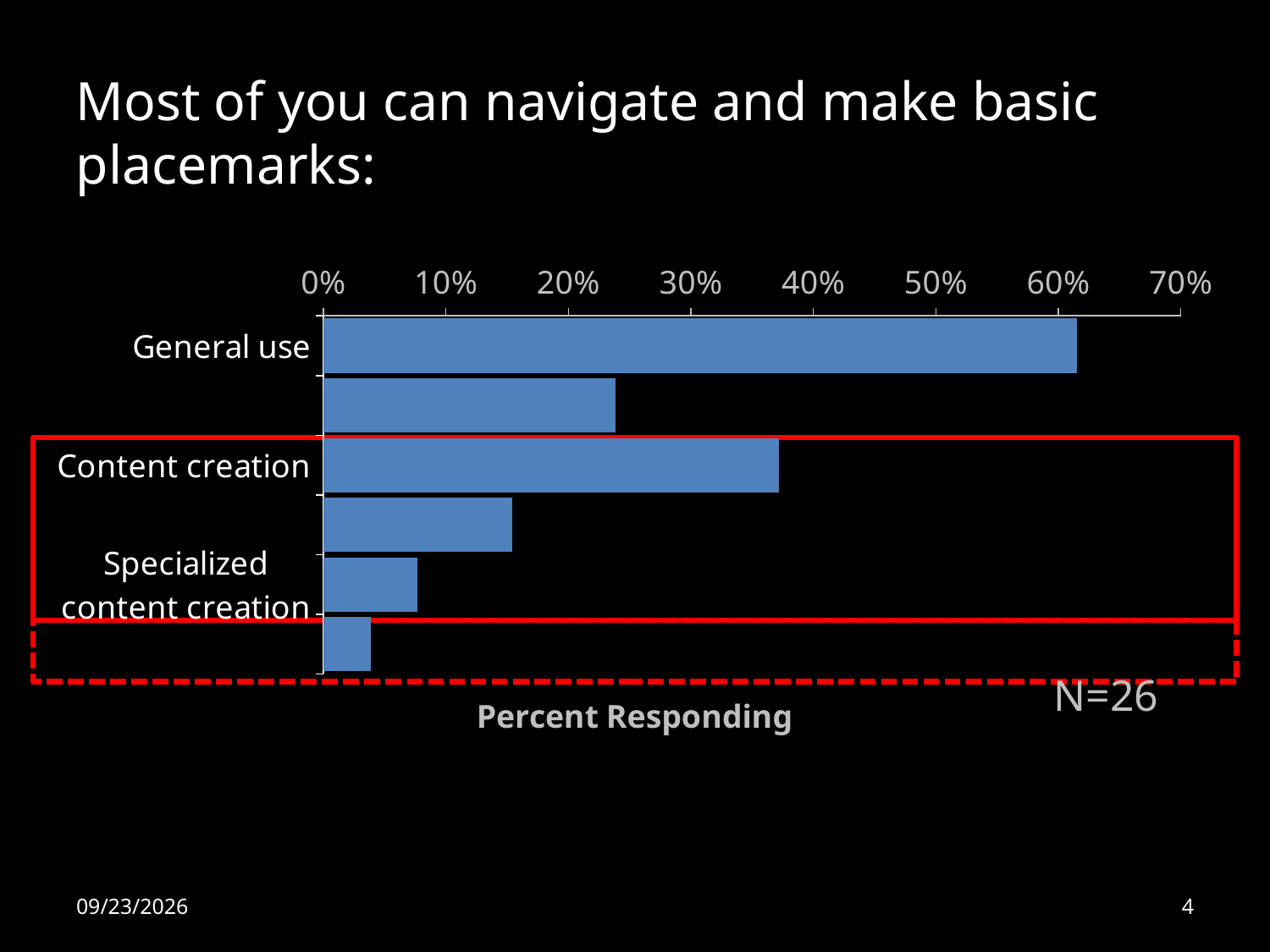
Which category has the highest value in the chart? General use Is the value for Content creation greater or less than 40%? less Which is larger, the value for Content creation or the value for Specialized content creation? Content creation Is the value for Content creation greater or less than 30%? greater What kind of chart is shown on the slide? bar chart How many bars are plotted in the chart? 6 Is the value for General use greater or less than 50%? greater What is the title of the horizontal axis? Percent Responding What is the highest tick value shown on the percentage axis? 70% Which is larger, the value for General use or the value for Content creation? General use